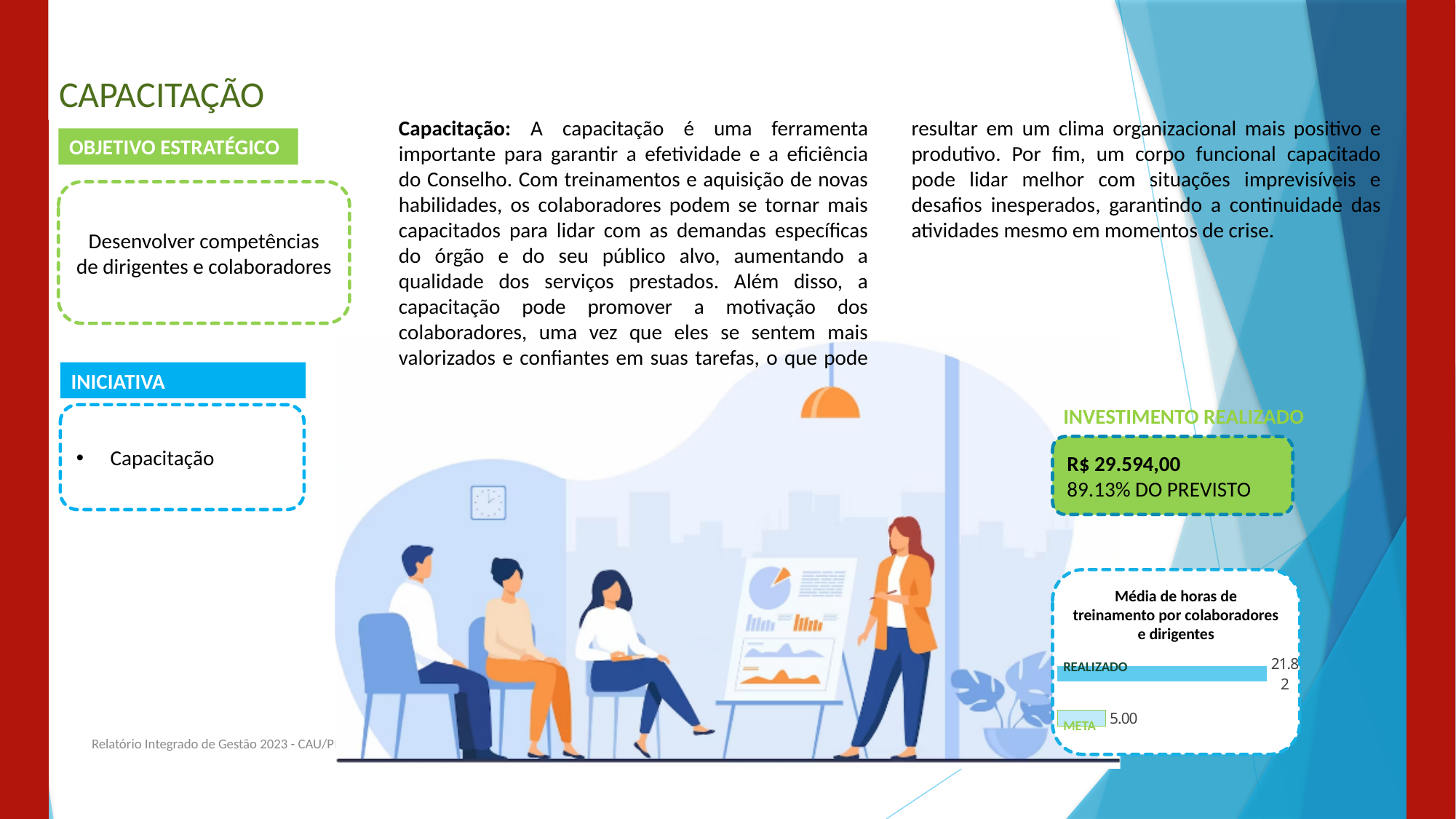
What kind of chart is shown on the slide? bar chart How many bars does the chart show? 2 Which category has the lowest value in the chart? META What is the value for META in the chart? 5.00 What is the difference between the REALIZADO and META values in the chart? 16.82 What are the two category labels shown on the chart? REALIZADO and META What is the value for REALIZADO in the chart? 21.82 Which is larger in the chart, REALIZADO or META? REALIZADO What is the title of the chart on the slide? Média de horas de treinamento por colaboradores e dirigentes Which category has the highest value in the chart? REALIZADO